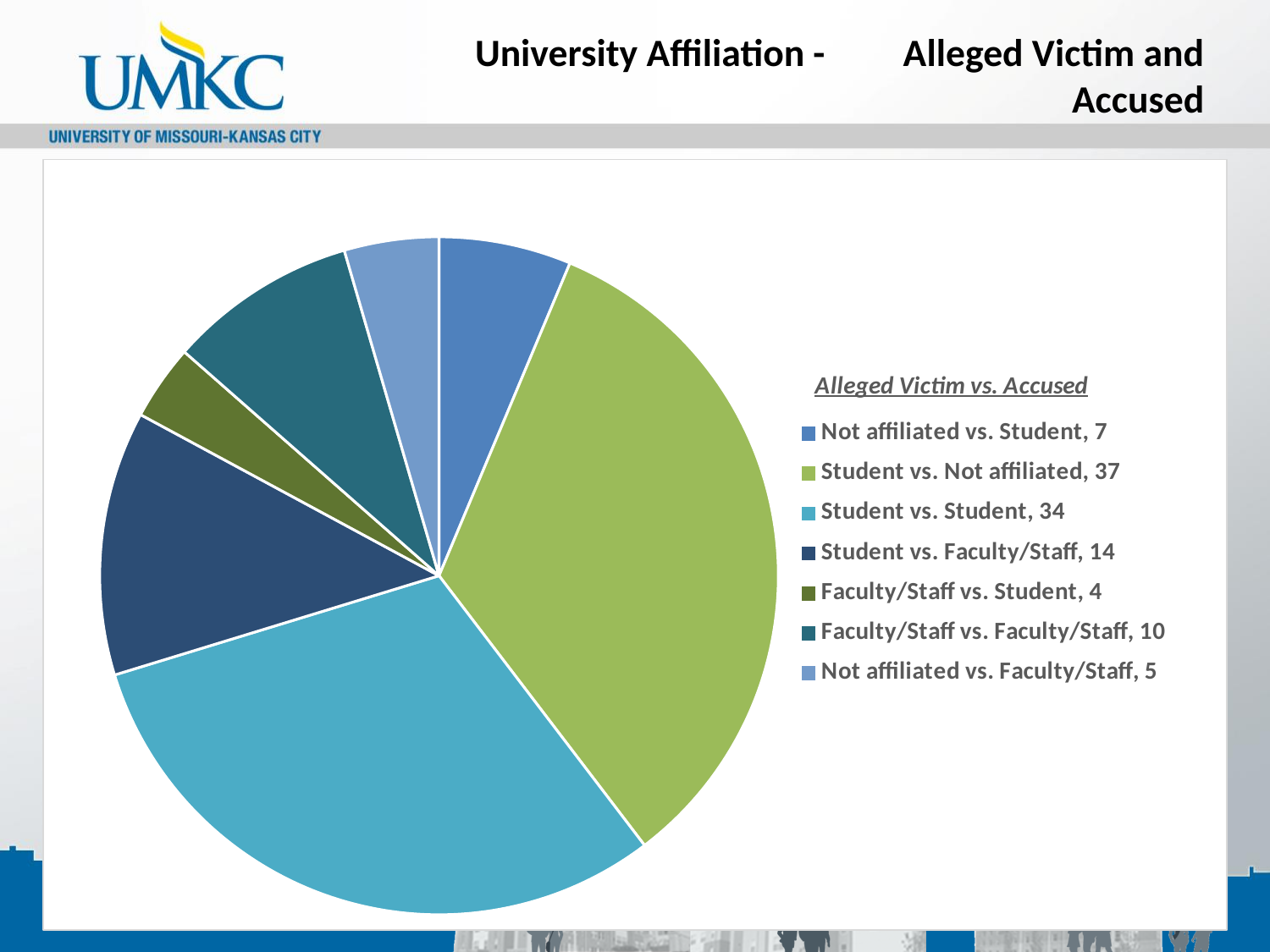
How many categories does the pie chart have? 7 What is the difference between Student vs. Not affiliated and Student vs. Student? 3 What is the value for Student vs. Student? 34 What is the total of all the values in the pie chart? 111 What is the title of the legend on the pie chart? Alleged Victim vs. Accused Which category has the largest slice of the pie? Student vs. Not affiliated What kind of chart is shown on the slide? pie chart Which is larger, Student vs. Faculty/Staff or Faculty/Staff vs. Faculty/Staff? Student vs. Faculty/Staff Which category has the smallest slice of the pie? Faculty/Staff vs. Student What is the value for Student vs. Not affiliated? 37 What is the value for Not affiliated vs. Faculty/Staff? 5